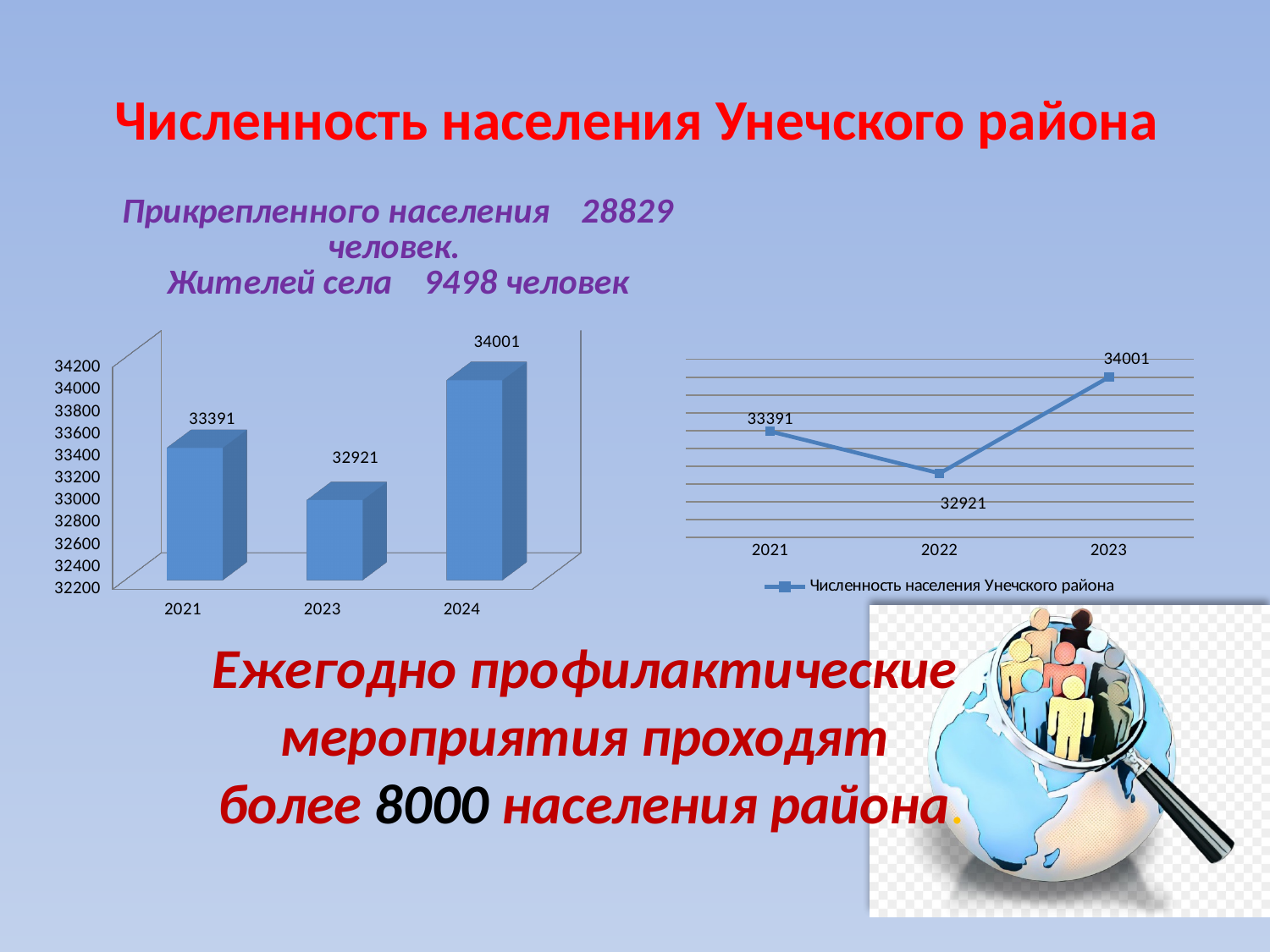
In the line chart on the right, which is larger, the value for 2021 or the value for 2023? 2023 What kind of chart is the chart on the left? bar chart In the bar chart on the left, what is the value for 2021? 33391 In the bar chart on the left, what is the difference between the values for 2024 and 2023? 1080 In the bar chart on the left, what is the value for 2024? 34001 What kind of chart is the chart on the right? line chart What is the legend entry of the line chart on the right? Численность населения Унечского района In the bar chart on the left, which year has the highest value? 2024 In the line chart on the right, what is the difference between the values for 2021 and 2022? 470 In the line chart on the right, what is the value for 2022? 32921 In the bar chart on the left, which year has the lowest value? 2023 In the bar chart on the left, how many bars are there? 3